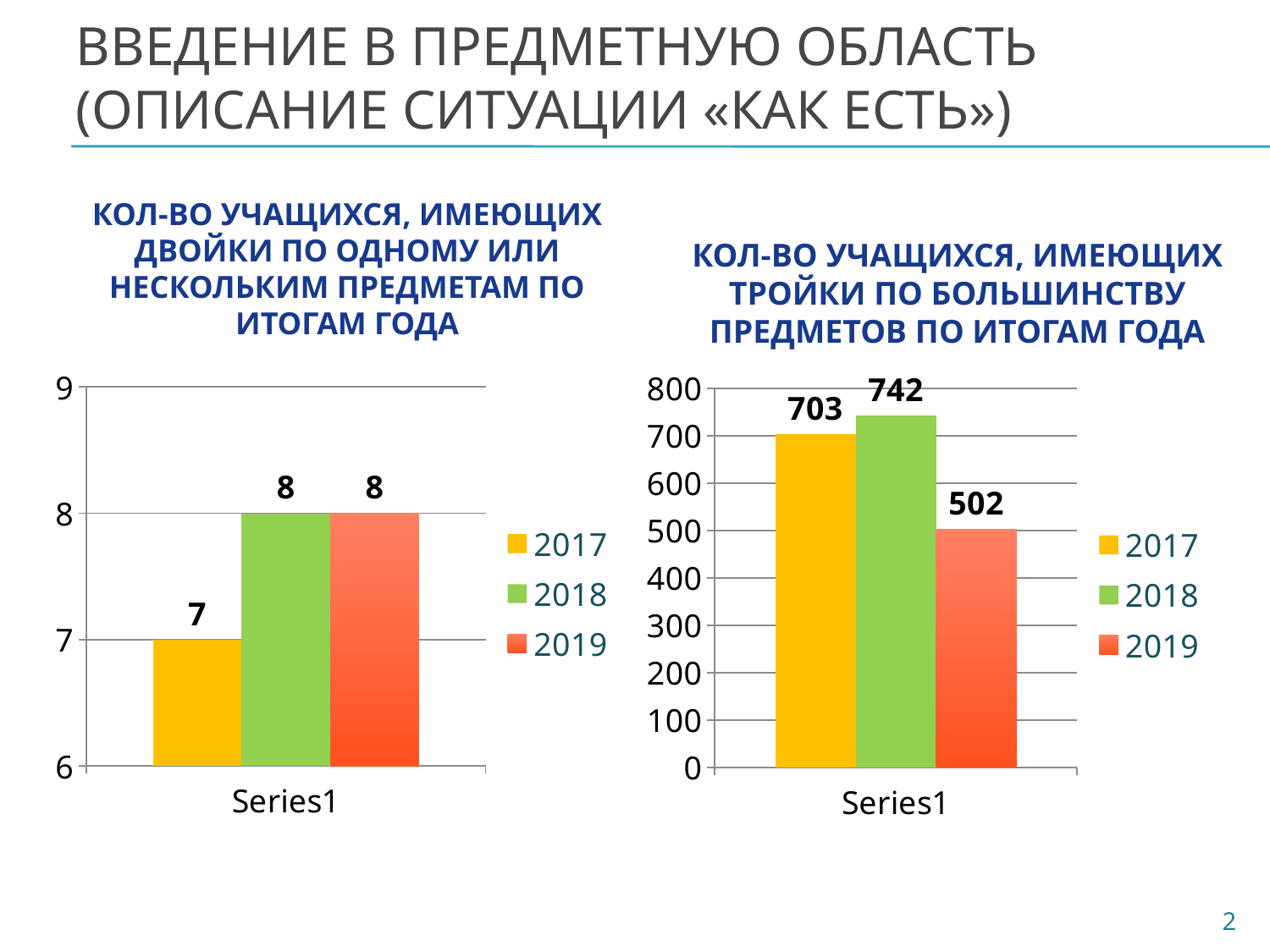
In the left chart, what colour is the bar for 2018? Green In the right chart, what is the difference between the values for 2018 and 2019? 240 How many series does the legend of the left chart list? 3 In the left chart (students with failing grades), what is the value for 2019? 8 In the left chart, which year has the lowest value? 2017 What kind of chart is the right chart? Bar chart In the right chart, which is larger, the value for 2017 or the value for 2018? 2018 In the right chart, which year has the highest value? 2018 In the left chart (students with failing grades), what is the value for 2017? 7 In the right chart, which year has the lowest value? 2019 In the right chart (students with satisfactory grades in most subjects), what is the value for 2018? 742 In the right chart (students with satisfactory grades in most subjects), what is the value for 2019? 502